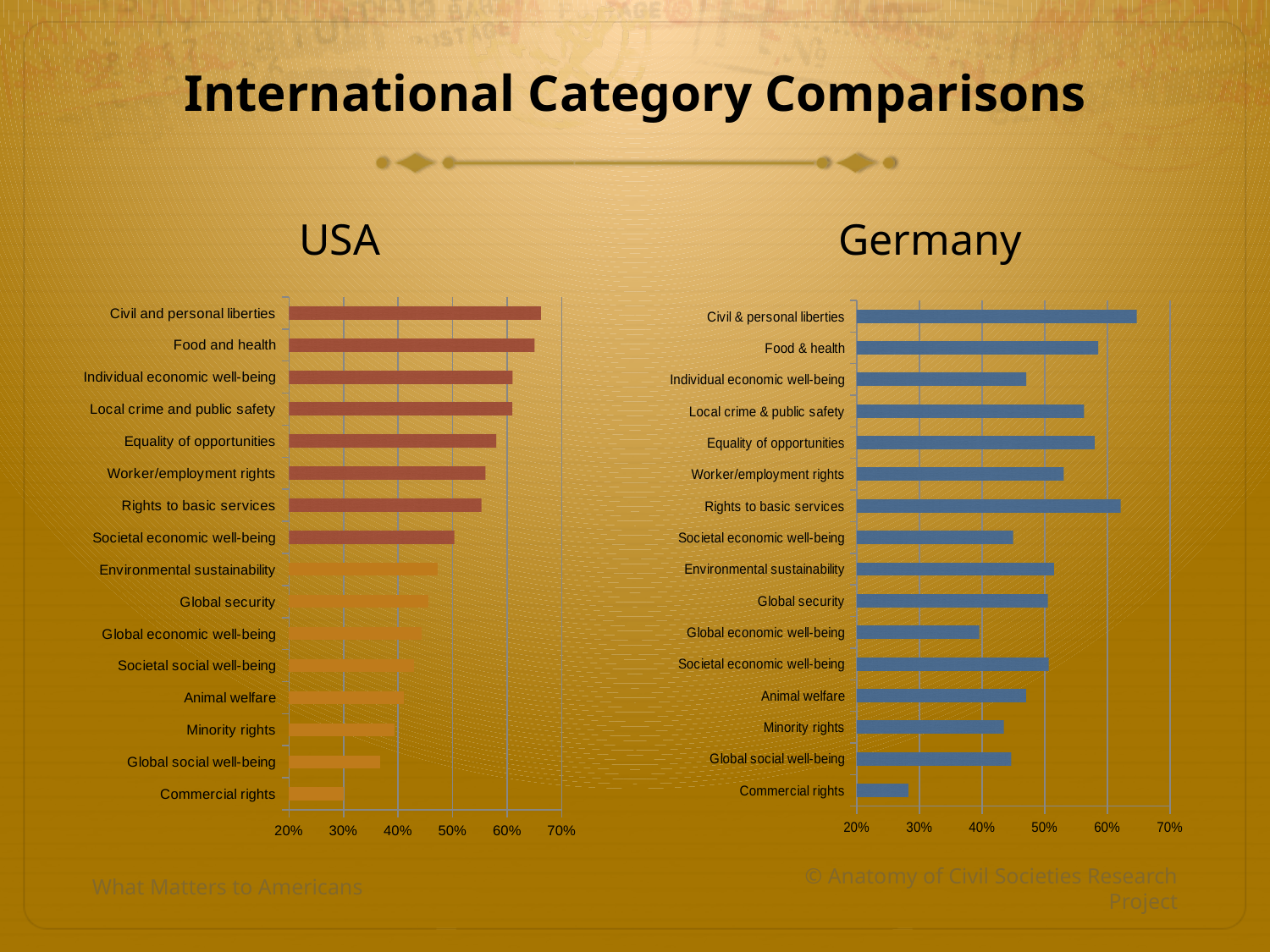
In the Germany chart, is the value for Rights to basic services greater or less than 60%? greater In the Germany chart, how many categories are shown? 16 In the Germany chart, is the value for Commercial rights greater or less than 30%? less In the USA chart, is the value for Civil and personal liberties greater or less than 60%? greater In the USA chart, how many categories are shown? 16 In the Germany chart, which category has the lowest value? Commercial rights In the Germany chart, which is larger: Rights to basic services or Societal economic well-being? Rights to basic services In the Germany chart, which category has the highest value? Civil & personal liberties What type of chart is used for the USA data? bar chart In the USA chart, do the bar values rise or fall going from the top category to the bottom category? fall In the USA chart, which category has the lowest value? Commercial rights